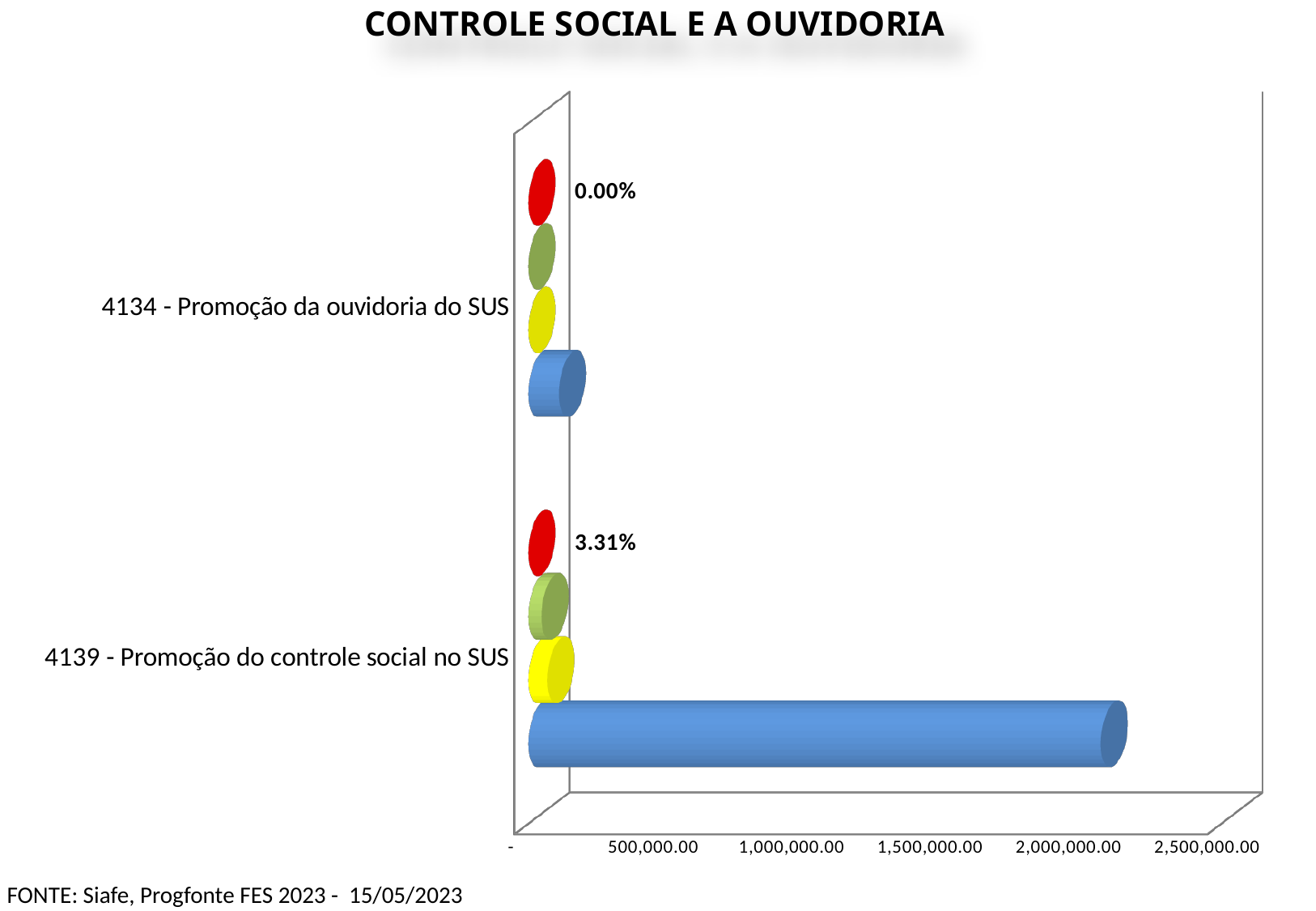
What percentage is labelled for the category 4139 - Promoção do controle social no SUS? 3.31% Is the value of the blue bar for 4139 - Promoção do controle social no SUS greater or less than 2,500,000.00? less How many categories are shown on the chart? 2 What is the title of the chart? CONTROLE SOCIAL E A OUVIDORIA Which category has the lower percentage label? 4134 - Promoção da ouvidoria do SUS Which category has the longer blue bar, 4134 - Promoção da ouvidoria do SUS or 4139 - Promoção do controle social no SUS? 4139 - Promoção do controle social no SUS Which category has the higher percentage label? 4139 - Promoção do controle social no SUS What kind of chart is shown on the slide? bar chart What source is cited below the chart? FONTE: Siafe, Progfonte FES 2023 - 15/05/2023 Is the value of the blue bar for 4134 - Promoção da ouvidoria do SUS greater or less than 500,000.00? less Is the value of the blue bar for 4139 - Promoção do controle social no SUS greater or less than 1,500,000.00? greater What percentage is labelled for the category 4134 - Promoção da ouvidoria do SUS? 0.00%